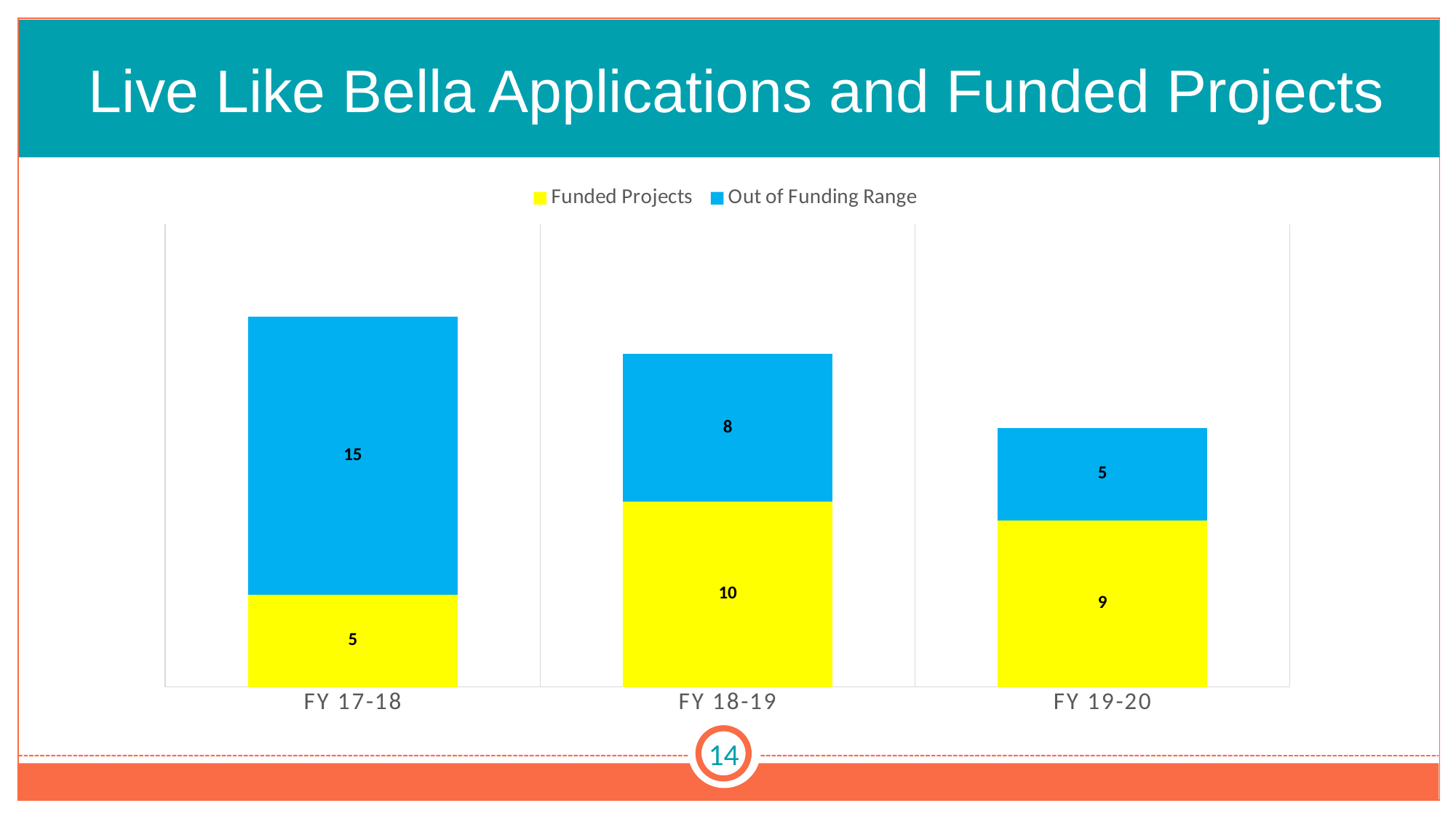
What is the total of the stacked bar for FY 19-20? 14 Which is larger: Funded Projects for FY 18-19 or Funded Projects for FY 19-20? FY 18-19 How many fiscal years are shown on the x axis? 3 What is the value of Out of Funding Range for FY 18-19? 8 How many series does the legend list? 2 What is the value of Funded Projects for FY 19-20? 9 What is the difference between Out of Funding Range for FY 17-18 and FY 19-20? 10 Which fiscal year has the lowest Funded Projects value? FY 17-18 What is the total of the stacked bar for FY 17-18? 20 Which fiscal year has the highest Out of Funding Range value? FY 17-18 What kind of chart is shown on the slide? Stacked bar chart What is the value of Funded Projects for FY 17-18? 5